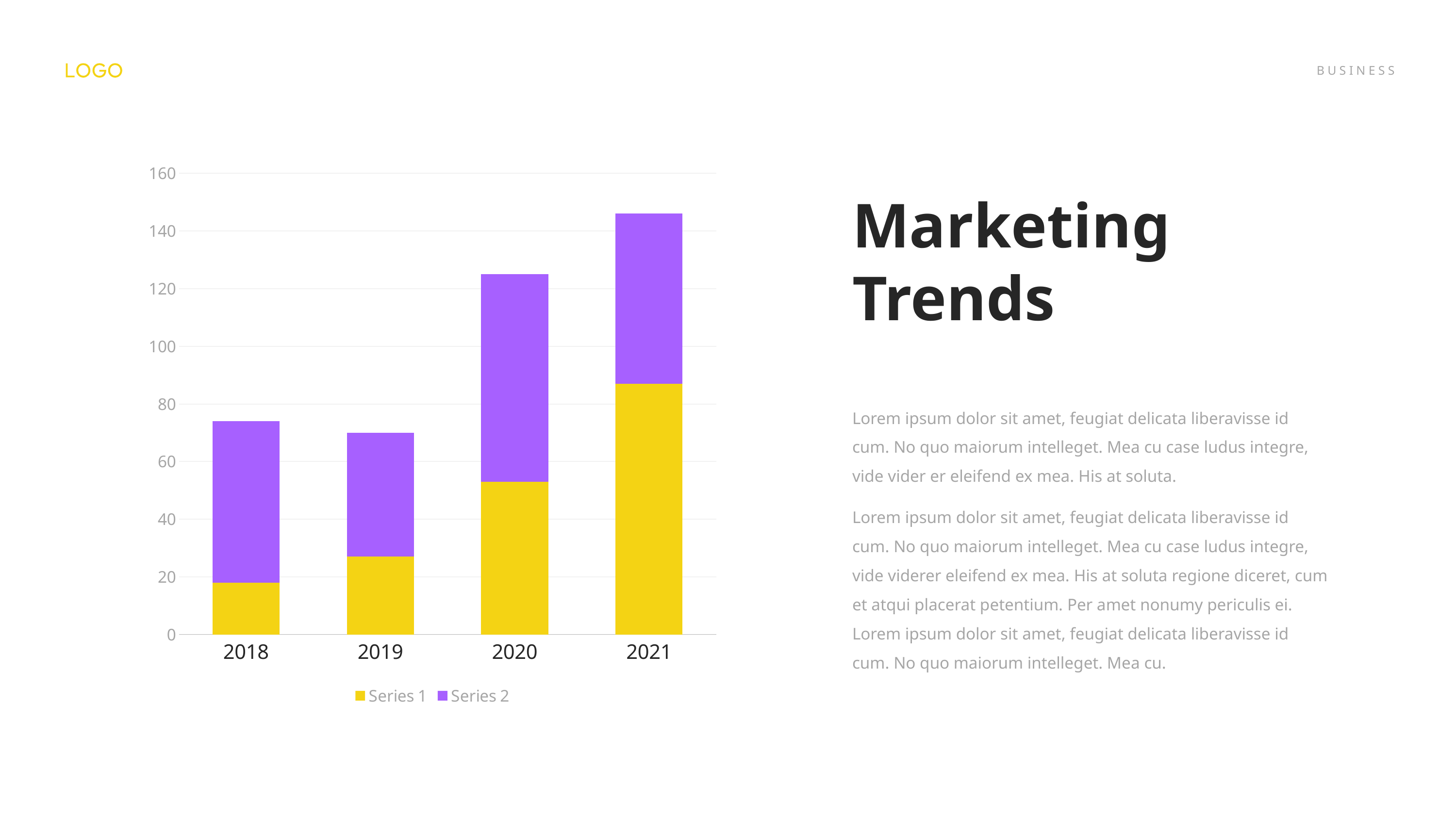
Which year has the larger total stacked bar, 2019 or 2020? 2020 What kind of chart is shown on the slide? Stacked bar chart Which year has the tallest stacked bar in the chart? 2021 Does the Series 1 value rise or fall from 2018 to 2021? rise Is the Series 1 value for 2021 greater or less than 80? greater What colour represents Series 1 in the chart? Yellow Which year has the smallest Series 1 segment in the chart? 2018 Is the Series 1 value for 2020 greater or less than 40? greater Is the total stacked bar for 2018 greater or less than 80? less How many years are shown on the x axis of the chart? 4 How many series does the chart's legend list? 2